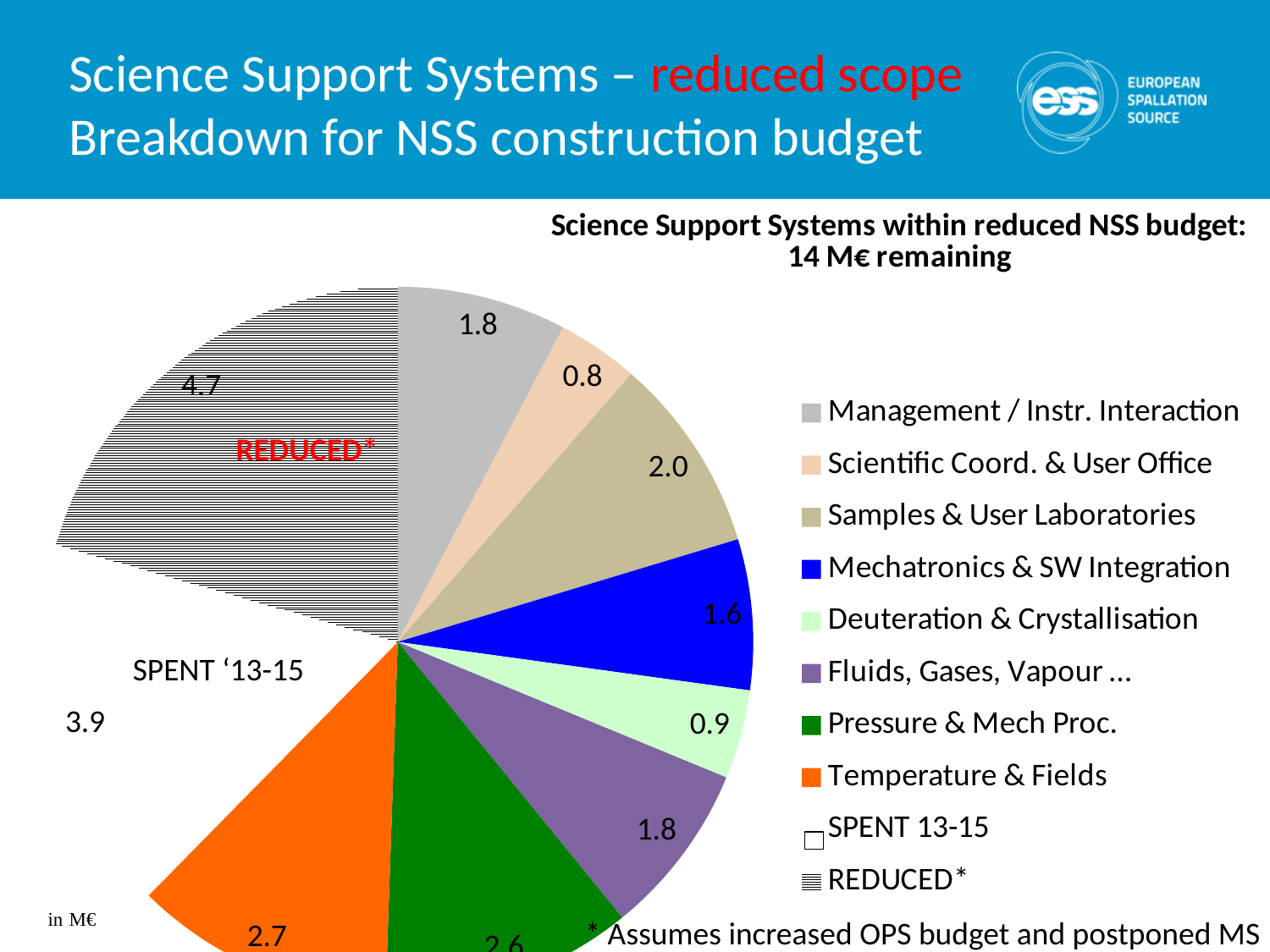
Which slice of the pie chart has the largest value? REDUCED* What kind of chart is shown on the slide? Pie chart What is the value of the REDUCED* slice in the pie chart? 4.7 What is the value of the SPENT 13-15 slice in the pie chart? 3.9 Which is larger: the value for Samples & User Laboratories or the value for Mechatronics & SW Integration? Samples & User Laboratories Which slice of the pie chart has the smallest value? Scientific Coord. & User Office What is the value for Samples & User Laboratories in the pie chart? 2.0 What is the value for Mechatronics & SW Integration in the pie chart? 1.6 What is the difference between the values for Temperature & Fields and Deuteration & Crystallisation? 1.8 What is the title of the pie chart? Science Support Systems within reduced NSS budget: 14 M€ remaining What is the value for Scientific Coord. & User Office in the pie chart? 0.8 How many entries does the legend of the pie chart list? 10